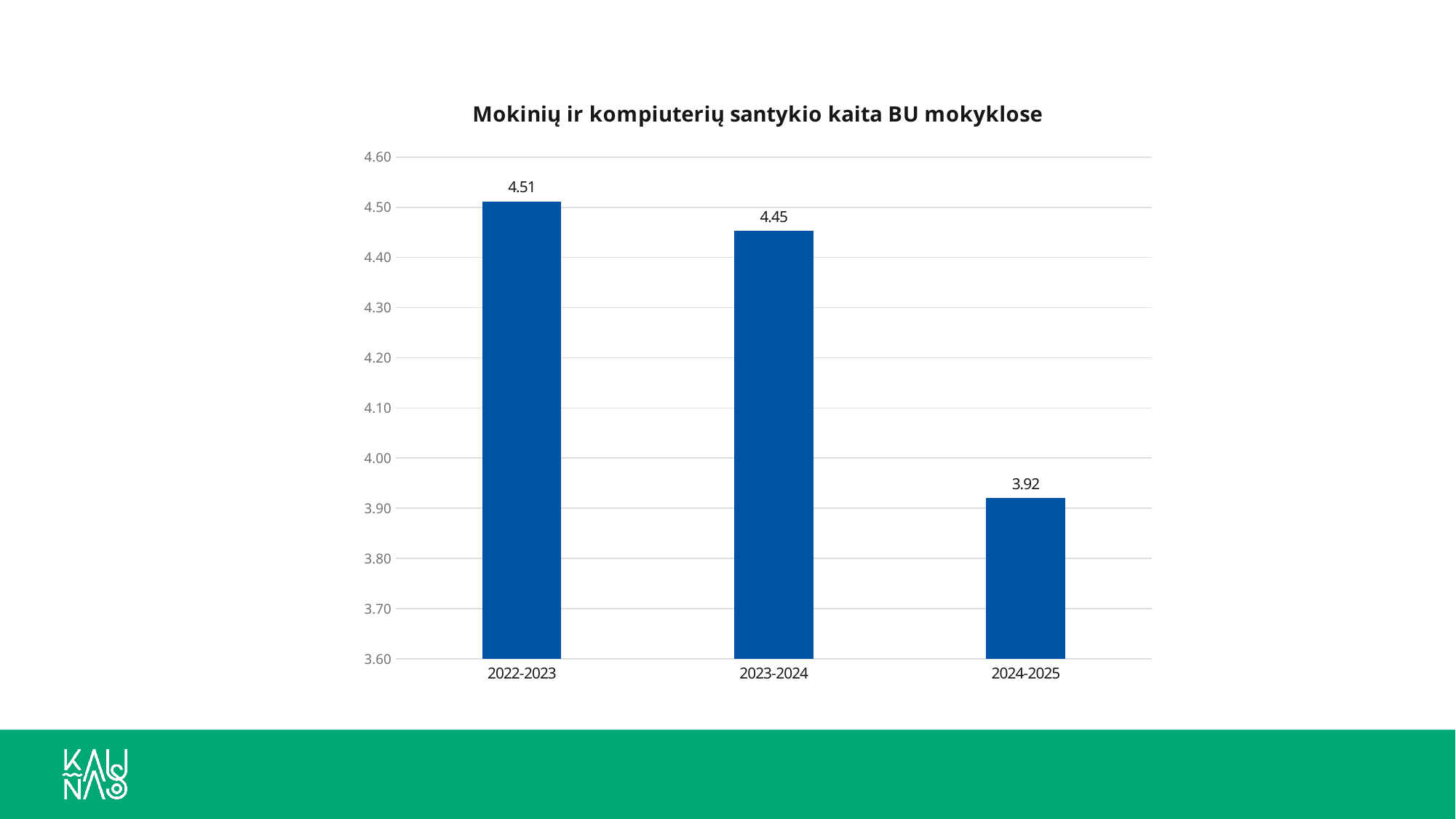
Which school year has the lowest value? 2024-2025 What is the value for 2022-2023? 4.51 What is the difference between the values for 2022-2023 and 2024-2025? 0.59 How many school years are shown on the chart? 3 What is the value for 2023-2024? 4.45 What is the difference between the values for 2022-2023 and 2023-2024? 0.06 Which is larger, the value for 2023-2024 or the value for 2024-2025? 2023-2024 Do the values rise or fall from 2022-2023 to 2024-2025? fall What kind of chart is shown on the slide? bar chart Which school year has the highest value? 2022-2023 Is the value for 2024-2025 greater or less than 4.00? less What is the value for 2024-2025? 3.92